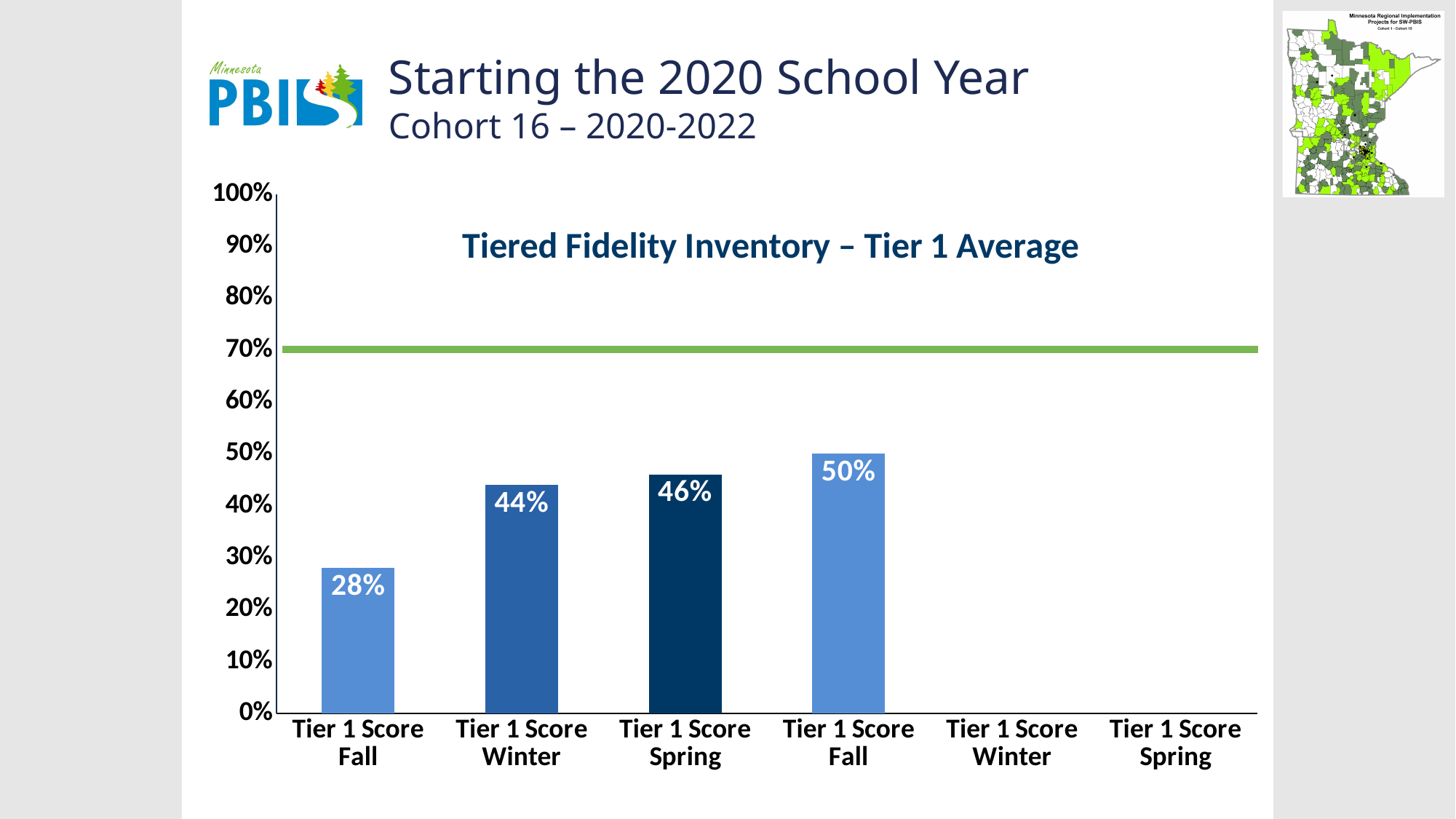
What is the value of the 'Tier 1 Score Winter' bar (the first Winter category)? 44% At what percentage is the horizontal green line drawn? 70% What is the value of the second 'Tier 1 Score Fall' bar? 50% How many category labels are shown on the x axis? 6 Which bar has the lowest value? The first Tier 1 Score Fall (28%) Which is larger, the first 'Tier 1 Score Winter' bar or the first 'Tier 1 Score Spring' bar? Tier 1 Score Spring (46%) What is the difference between the second 'Tier 1 Score Fall' bar and the first 'Tier 1 Score Fall' bar? 22% What kind of chart is shown on the slide? Bar chart Which bar has the highest value? The second Tier 1 Score Fall (50%) What is the value of the 'Tier 1 Score Spring' bar (the first Spring category)? 46% What is the value of the first 'Tier 1 Score Fall' bar? 28% How many bars have plotted values in the chart? 4